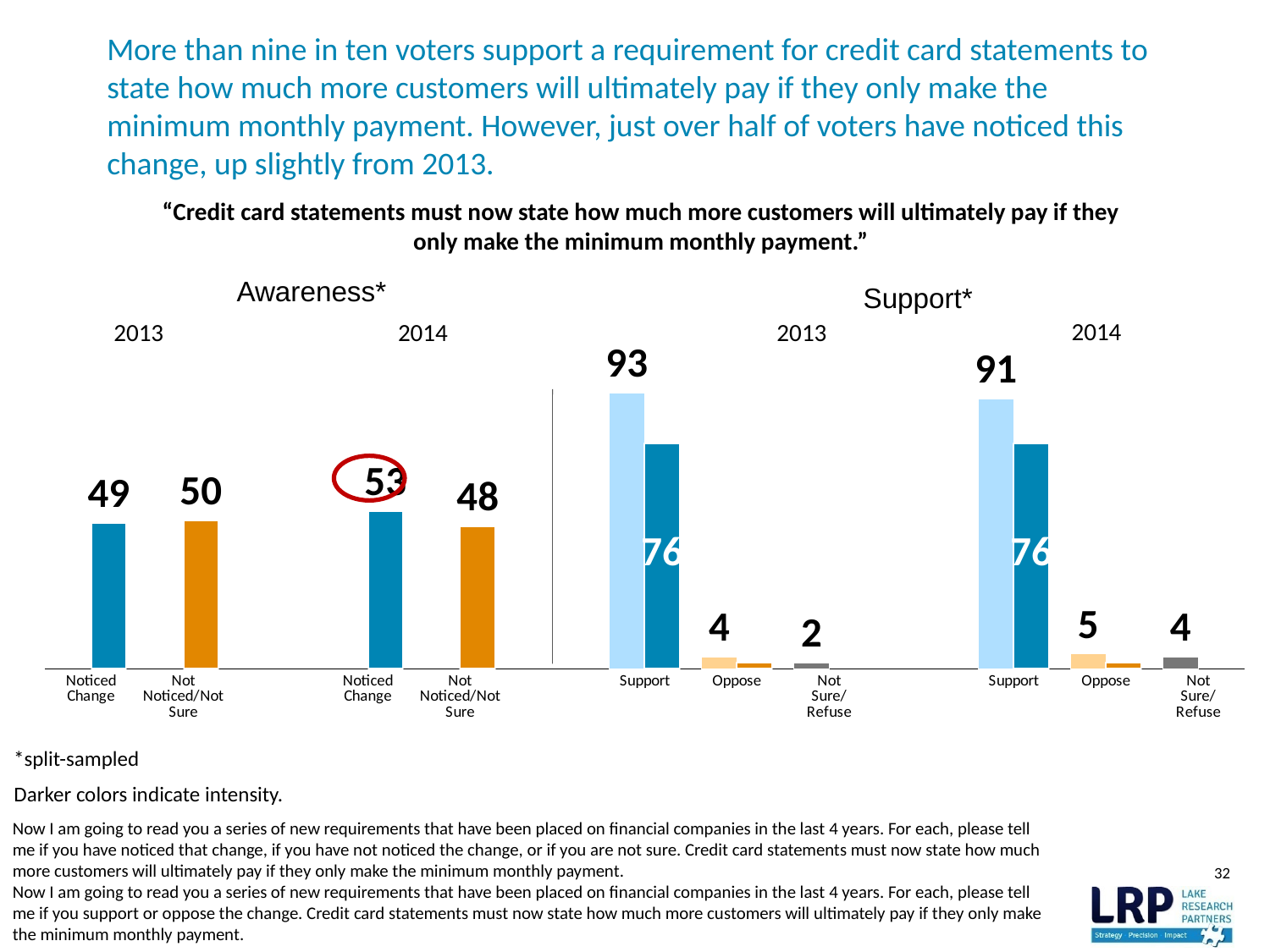
In the Support chart, what is the value for Oppose in 2014? 5 In the Awareness chart, what is the value for Not Noticed/Not Sure in 2013? 50 In the Support chart, what is the difference between Support in 2013 and Support in 2014? 2 In the Awareness chart, what is the value for Noticed Change in 2014? 53 In the Awareness chart, which value is circled in red? 53 In the Support chart, what is the intensity (darker bar) value for Support in 2014? 76 In the Awareness chart, which is larger in 2014: Noticed Change or Not Noticed/Not Sure? Noticed Change In the Support chart, what is the value for Not Sure/Refuse in 2013? 2 In the Awareness chart, by how much did Noticed Change increase from 2013 to 2014? 4 In the Support chart, what is the value for Support in 2013? 93 What kind of chart is the Support chart? Bar chart In the Support chart, which category has the lowest value in 2013? Not Sure/Refuse